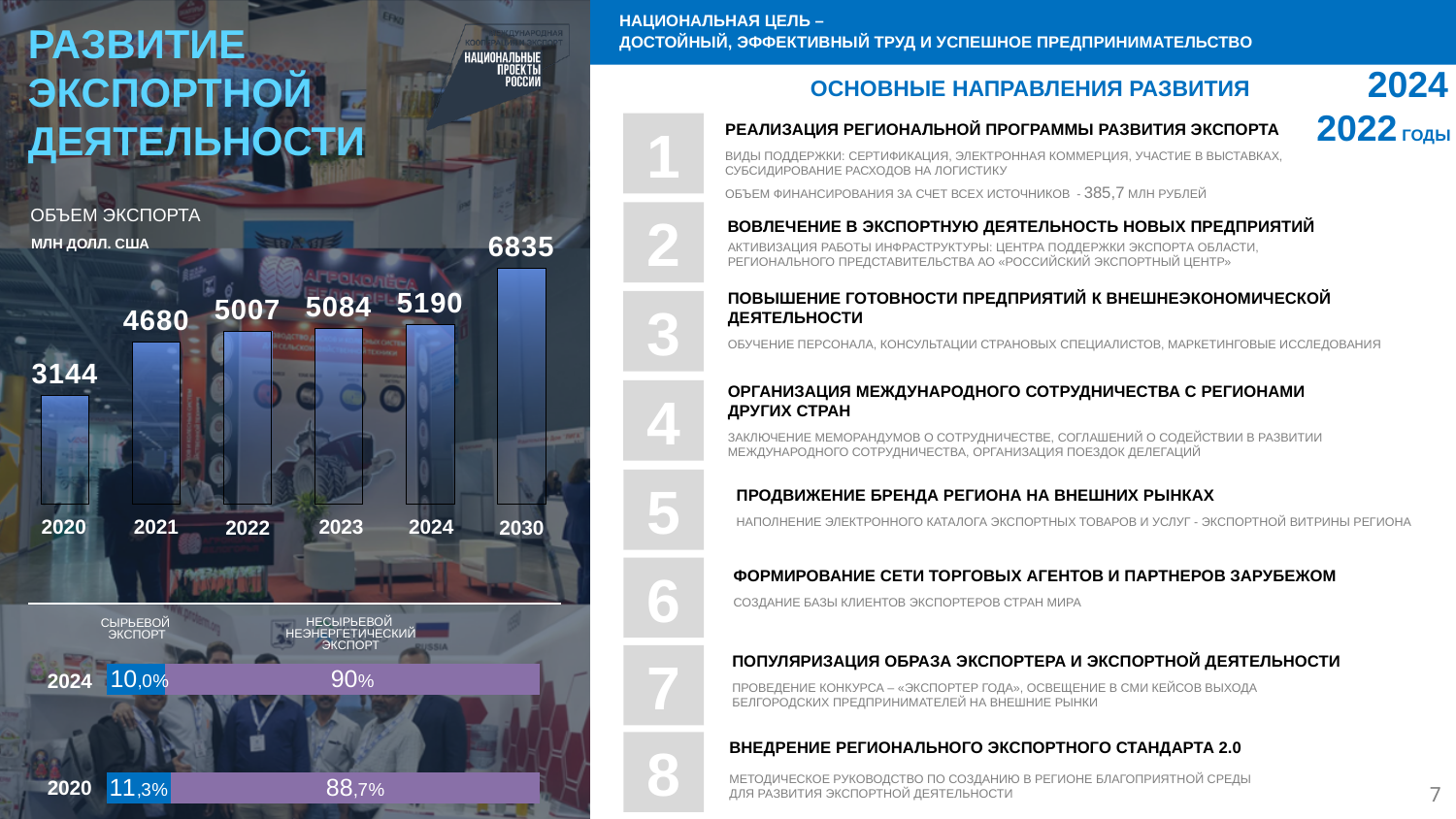
On the 'ОБЪЕМ ЭКСПОРТА' bar chart, which year has the lowest value? 2020 On the 'ОБЪЕМ ЭКСПОРТА' bar chart, how many bars are shown? 6 On the 'ОБЪЕМ ЭКСПОРТА' bar chart, do the values rise or fall from 2020 to 2030? rise What kind of chart is the 'ОБЪЕМ ЭКСПОРТА' chart? bar chart On the 'ОБЪЕМ ЭКСПОРТА' bar chart, what is the value for 2030? 6835 On the stacked bar chart at the bottom left, what is the share of 'НЕСЫРЬЕВОЙ НЕЭНЕРГЕТИЧЕСКИЙ ЭКСПОРТ' in 2024? 90% On the stacked bar chart at the bottom left, how many series does the legend list? 2 On the 'ОБЪЕМ ЭКСПОРТА' bar chart, what is the value for 2020? 3144 On the 'ОБЪЕМ ЭКСПОРТА' bar chart, which year has the highest value? 2030 On the 'ОБЪЕМ ЭКСПОРТА' bar chart, what is the value for 2023? 5084 On the 'ОБЪЕМ ЭКСПОРТА' bar chart, what is the difference between the values for 2021 and 2020? 1536 On the stacked bar chart at the bottom left, what is the share of 'СЫРЬЕВОЙ ЭКСПОРТ' in 2020? 11,3%